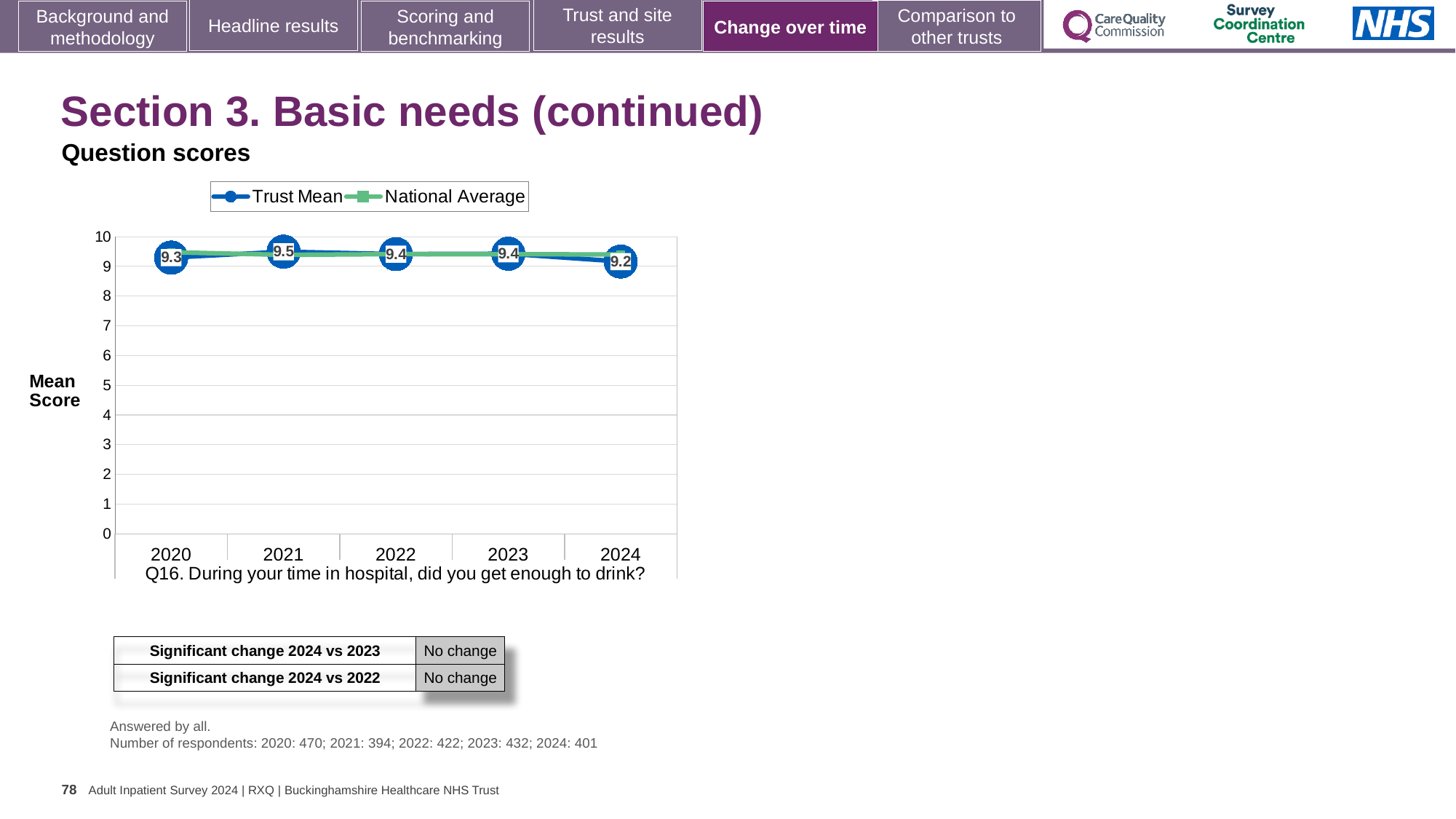
Is the Trust Mean score for 2022 greater or less than 8? greater In which year is the Trust Mean score highest? 2021 What is the Trust Mean score for 2024? 9.2 How many years are shown on the x axis of the chart? 5 How many series does the chart legend list? 2 What is the Trust Mean score for 2020? 9.3 What kind of chart is shown on the slide? Line chart Which is larger, the Trust Mean score for 2020 or for 2021? 2021 Which series is shown in green in the chart legend? National Average In which year is the Trust Mean score lowest? 2024 What is the difference between the Trust Mean scores for 2021 and 2024? 0.3 What is the Trust Mean score for 2021? 9.5